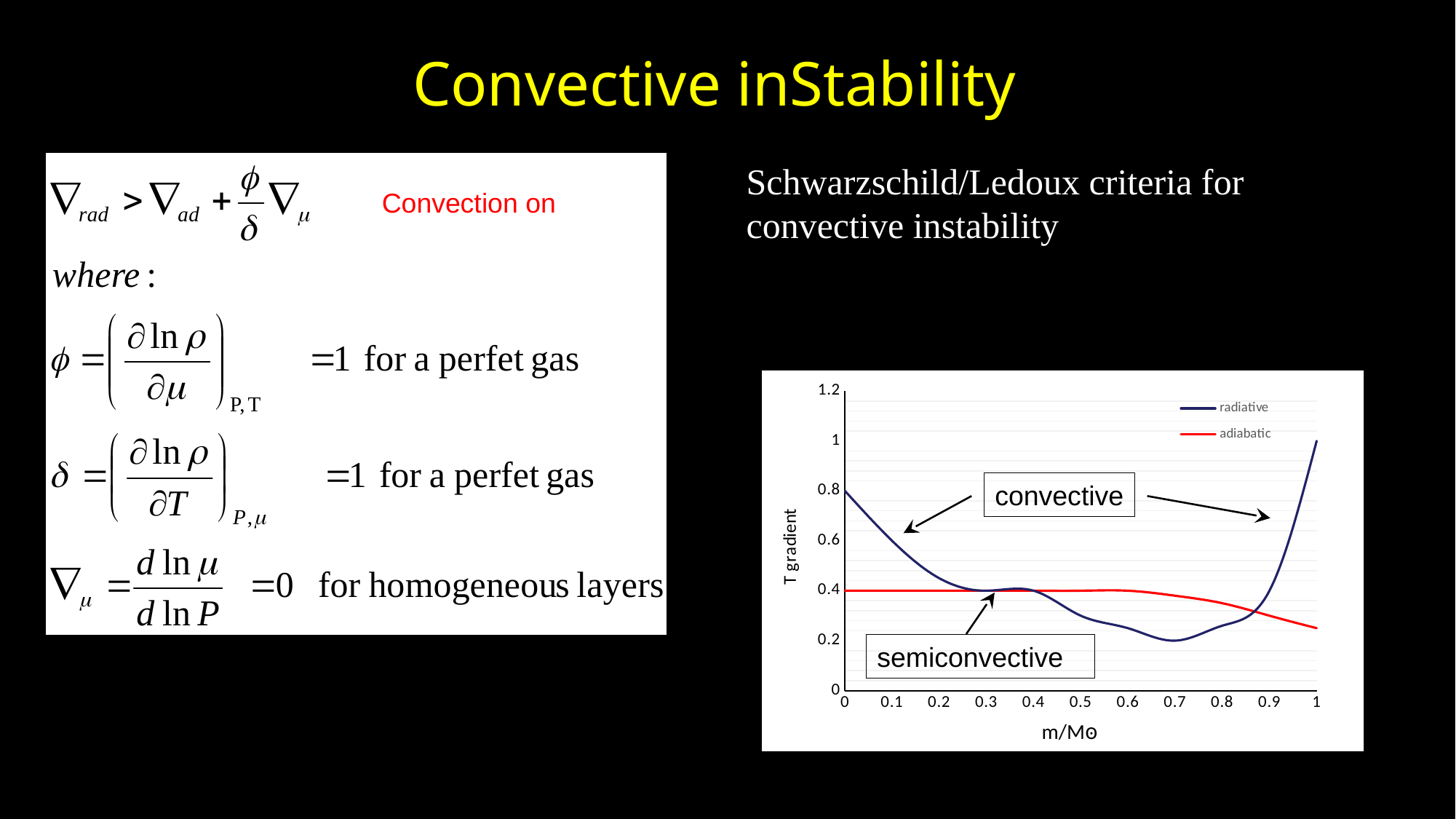
What kind of chart is shown on the slide? line chart Is the adiabatic T gradient at m/M☉ = 0.5 greater or less than 0.6? less Which series reaches the highest T gradient value anywhere on the chart? radiative What are the two series named in the chart's legend? radiative and adiabatic What colour is the adiabatic line in the chart? red At m/M☉ = 0.7, which series has the higher T gradient, radiative or adiabatic? adiabatic Is the radiative T gradient at m/M☉ = 1 greater or less than 0.8? greater Does the radiative T gradient rise or fall as m/M☉ goes from 0.8 to 1? rise Does the radiative T gradient rise or fall as m/M☉ goes from 0 to 0.3? fall Is the radiative T gradient at m/M☉ = 0.7 greater or less than 0.4? less At m/M☉ = 0.1, which series has the higher T gradient, radiative or adiabatic? radiative How many series does the chart's legend list? 2